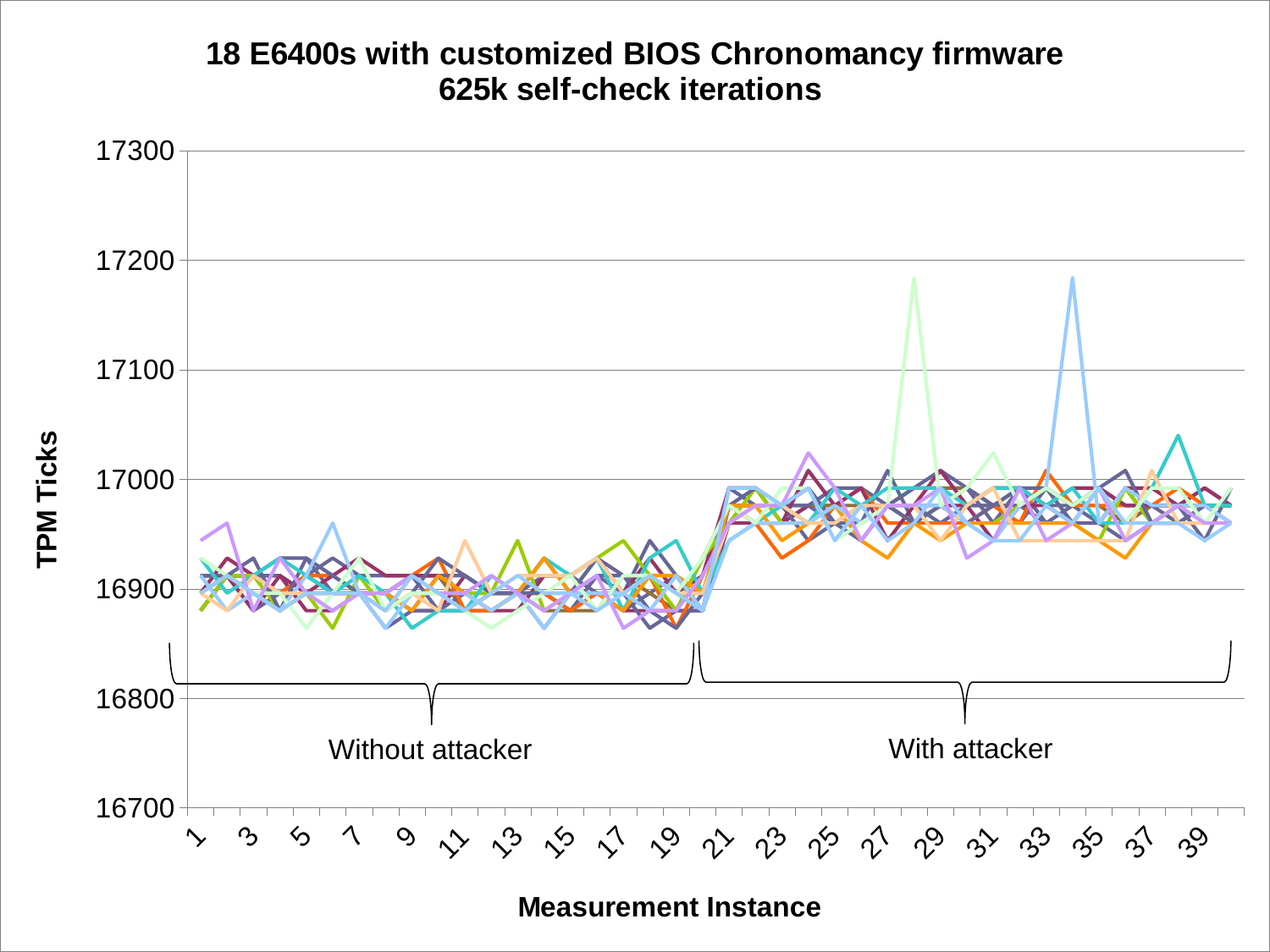
Are the values at measurement instance 30 greater or less than 16900? greater Is the highest spike in the 'With attacker' region greater or less than 17100? greater Do the values rise or fall when moving from the 'Without attacker' region to the 'With attacker' region? rise Is the highest spike in the 'With attacker' region greater or less than 17200? less What is the highest value shown on the y axis? 17300 What is the label of the y axis? TPM Ticks What kind of chart is shown on the slide? line chart Which region has higher TPM Ticks values, 'Without attacker' or 'With attacker'? With attacker What is the title of the chart? 18 E6400s with customized BIOS Chronomancy firmware 625k self-check iterations